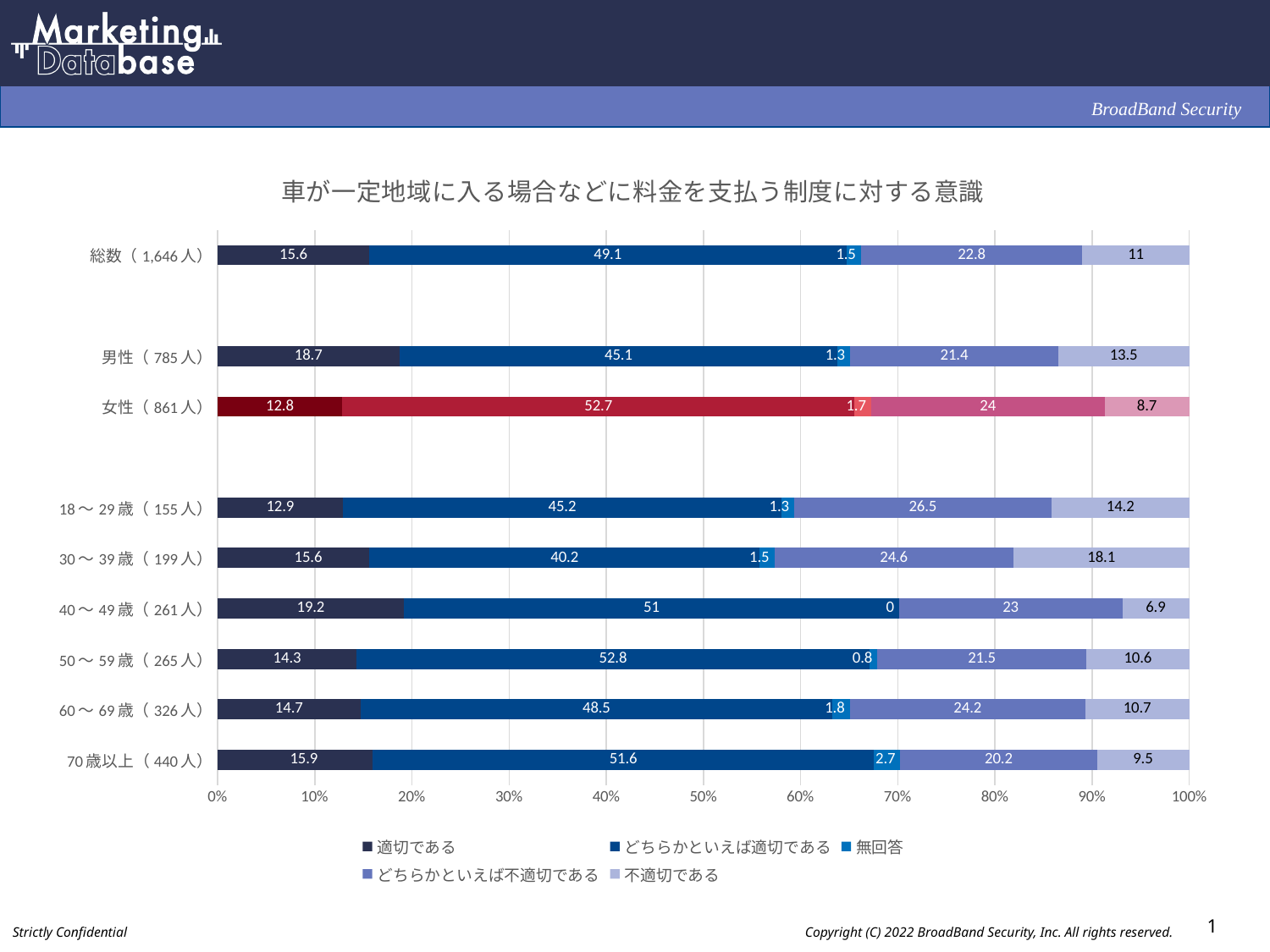
How many series does the legend list? 5 What is the value of 無回答 for 40〜49歳（261人）? 0 What kind of chart is shown on the slide? Stacked bar chart Which category has the lowest value for 不適切である? 40〜49歳（261人） What is the title of the chart? 車が一定地域に入る場合などに料金を支払う制度に対する意識 What is the value of 適切である for 男性（785人）? 18.7 What is the value of どちらかといえば適切である for 女性（861人）? 52.7 What is the value of 不適切である for 30〜39歳（199人）? 18.1 How many categories are shown on the chart? 9 What is the difference between the 適切である values for 男性（785人） and 女性（861人）? 5.9 Which is larger: the どちらかといえば不適切である value for 18〜29歳（155人） or for 70歳以上（440人）? 18〜29歳（155人） Which category has the highest value for 適切である? 40〜49歳（261人）